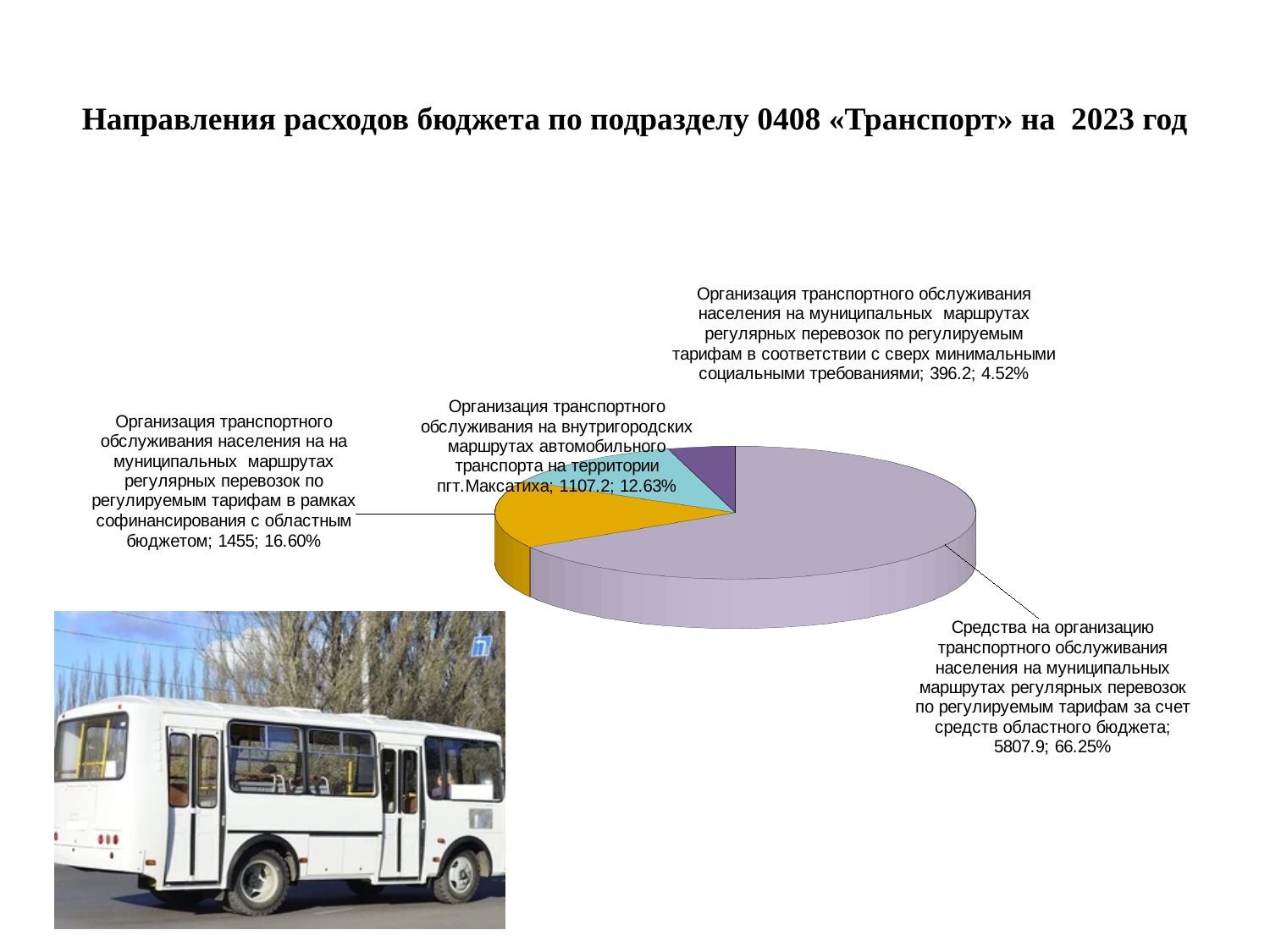
Какая доля приходится на сектор «Организация транспортного обслуживания населения на муниципальных маршрутах регулярных перевозок по регулируемым тарифам в соответствии с сверх минимальными социальными требованиями»? 4.52% Какое значение указано для сектора «Средства на организацию транспортного обслуживания населения на муниципальных маршрутах регулярных перевозок по регулируемым тарифам за счет средств областного бюджета»? 5807.9 Что больше: значение сектора «за счет средств областного бюджета» или сектора «в рамках софинансирования с областным бюджетом»? За счет средств областного бюджета На сколько значение сектора «в рамках софинансирования с областным бюджетом» (1455) больше значения сектора «на территории пгт.Максатиха» (1107.2)? 347.8 Какой тип диаграммы показан на слайде? Круговая диаграмма Какова сумма всех значений секторов диаграммы? 8766.3 Как называется диаграмма на слайде? Направления расходов бюджета по подразделу 0408 «Транспорт» на 2023 год Какая доля приходится на сектор «Организация транспортного обслуживания на внутригородских маршрутах автомобильного транспорта на территории пгт.Максатиха»? 12.63% Какое значение указано для сектора «Организация транспортного обслуживания населения на муниципальных маршрутах регулярных перевозок по регулируемым тарифам в рамках софинансирования с областным бюджетом»? 1455 Какой сектор диаграммы имеет наибольшее значение? Средства на организацию транспортного обслуживания населения на муниципальных маршрутах регулярных перевозок по регулируемым тарифам за счет средств областного бюджета Сколько секторов (категорий) содержит круговая диаграмма? 4 Какой сектор диаграммы имеет наименьшее значение? Организация транспортного обслуживания населения на муниципальных маршрутах регулярных перевозок по регулируемым тарифам в соответствии с сверх минимальными социальными требованиями